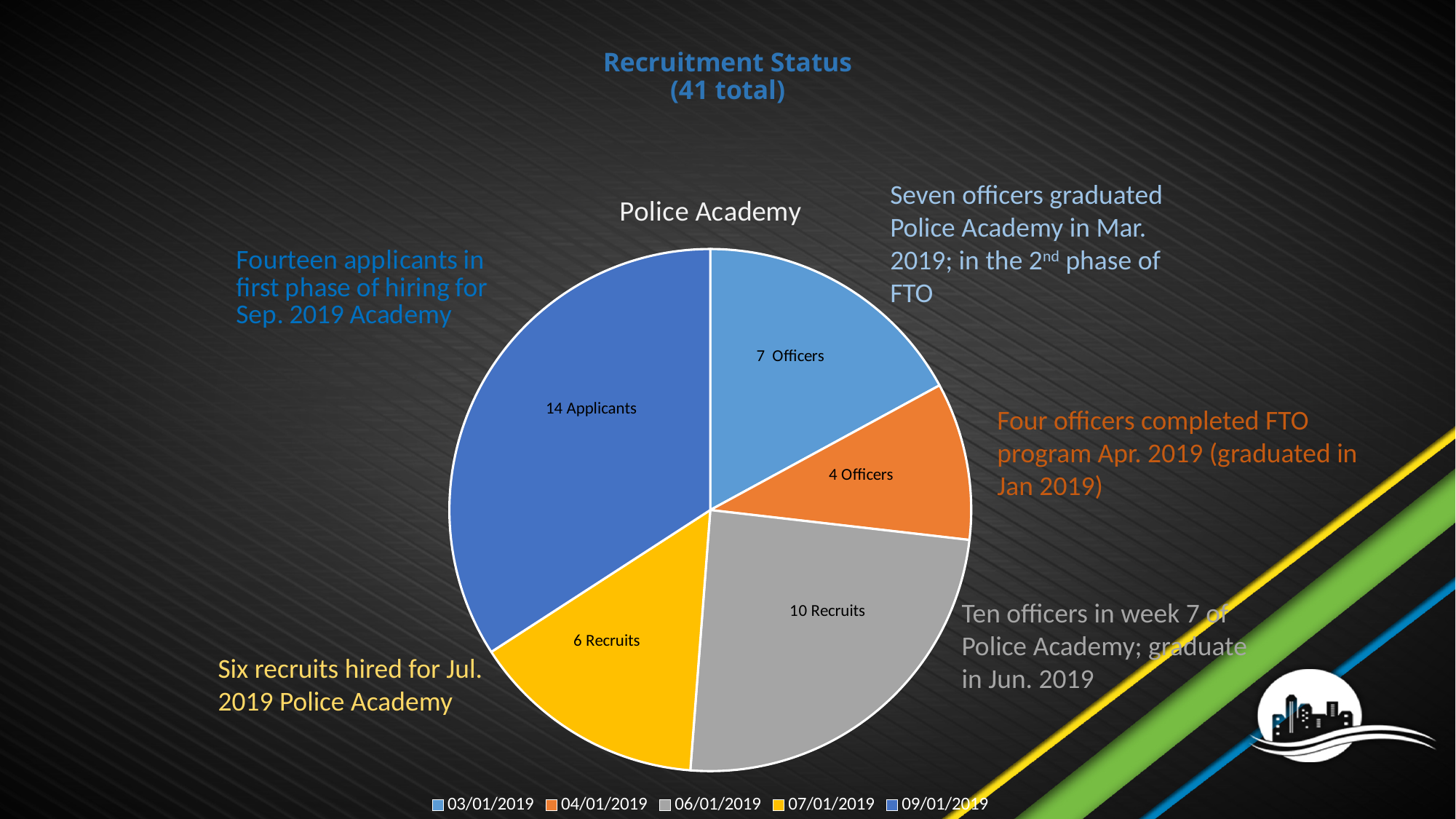
How many entries does the legend list? 5 What is the title of the chart? Police Academy Which slice is the smallest? 04/01/2019 (4 Officers) Which slice is the largest? 09/01/2019 (14 Applicants) What is the value of the 04/01/2019 slice? 4 Officers What is the value of the 06/01/2019 slice? 10 Recruits Which is larger, the 03/01/2019 slice or the 07/01/2019 slice? 03/01/2019 (7 Officers) What is the total of all slices in the pie chart? 41 How many slices does the pie chart have? 5 What is the value of the 09/01/2019 slice? 14 Applicants What kind of chart is shown on the slide? Pie chart What is the difference between the 14 Applicants slice and the 6 Recruits slice? 8